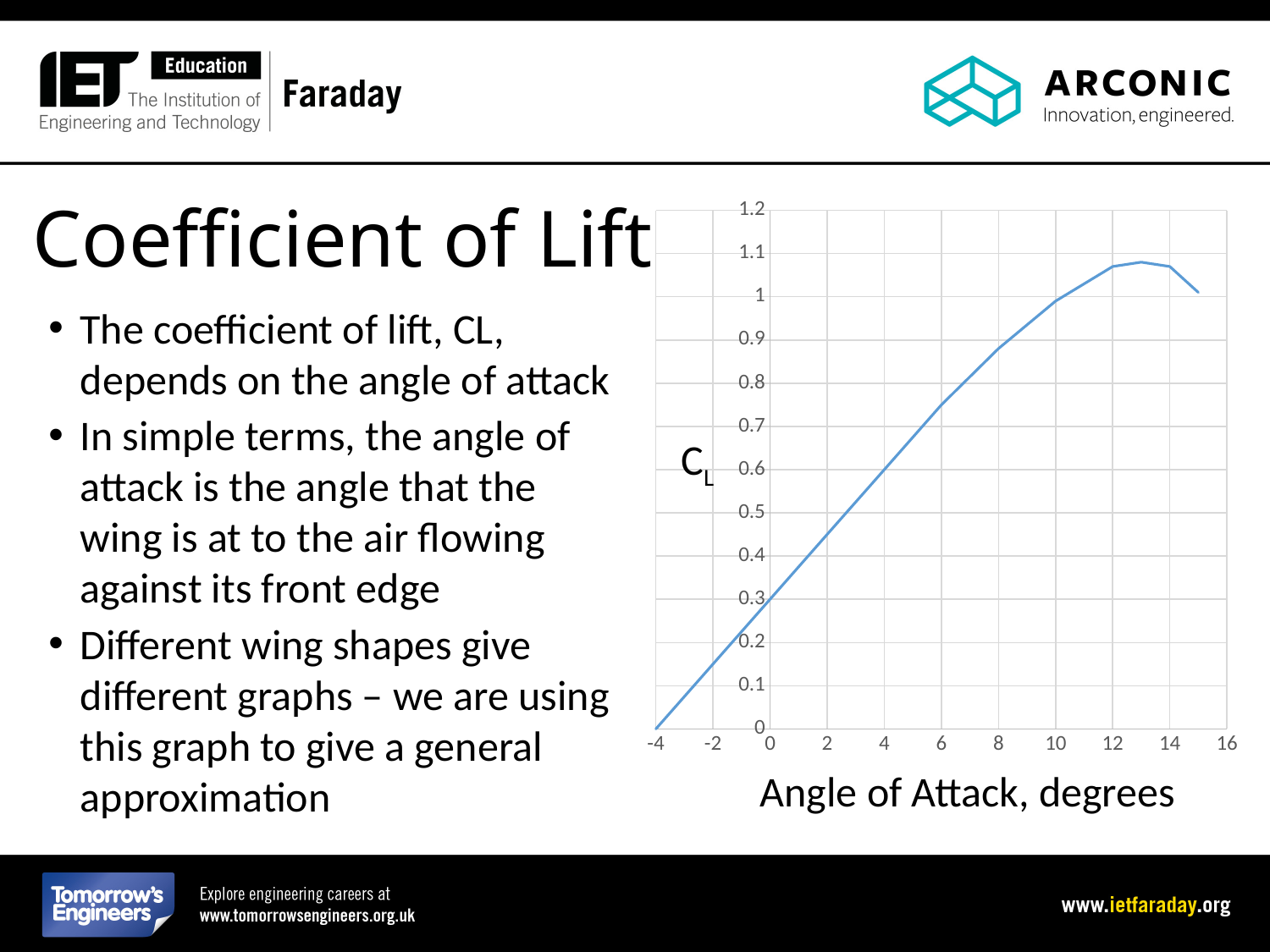
Is the value of CL at an angle of attack of 12 degrees greater or less than 1? greater What is the label of the y axis of the chart? CL Is CL larger at an angle of attack of 6 degrees or at 2 degrees? 6 degrees What kind of chart is shown on the slide? line chart Does CL rise or fall as the angle of attack increases from 14 to 15 degrees? fall What is the label of the x axis of the chart? Angle of Attack, degrees Is the value of CL at an angle of attack of 15 degrees greater or less than 1.1? less Does CL rise or fall as the angle of attack increases from -4 to 10 degrees? rise Is the value of CL at an angle of attack of 8 degrees greater or less than 0.8? greater What is the value of CL at an angle of attack of -4 degrees? 0